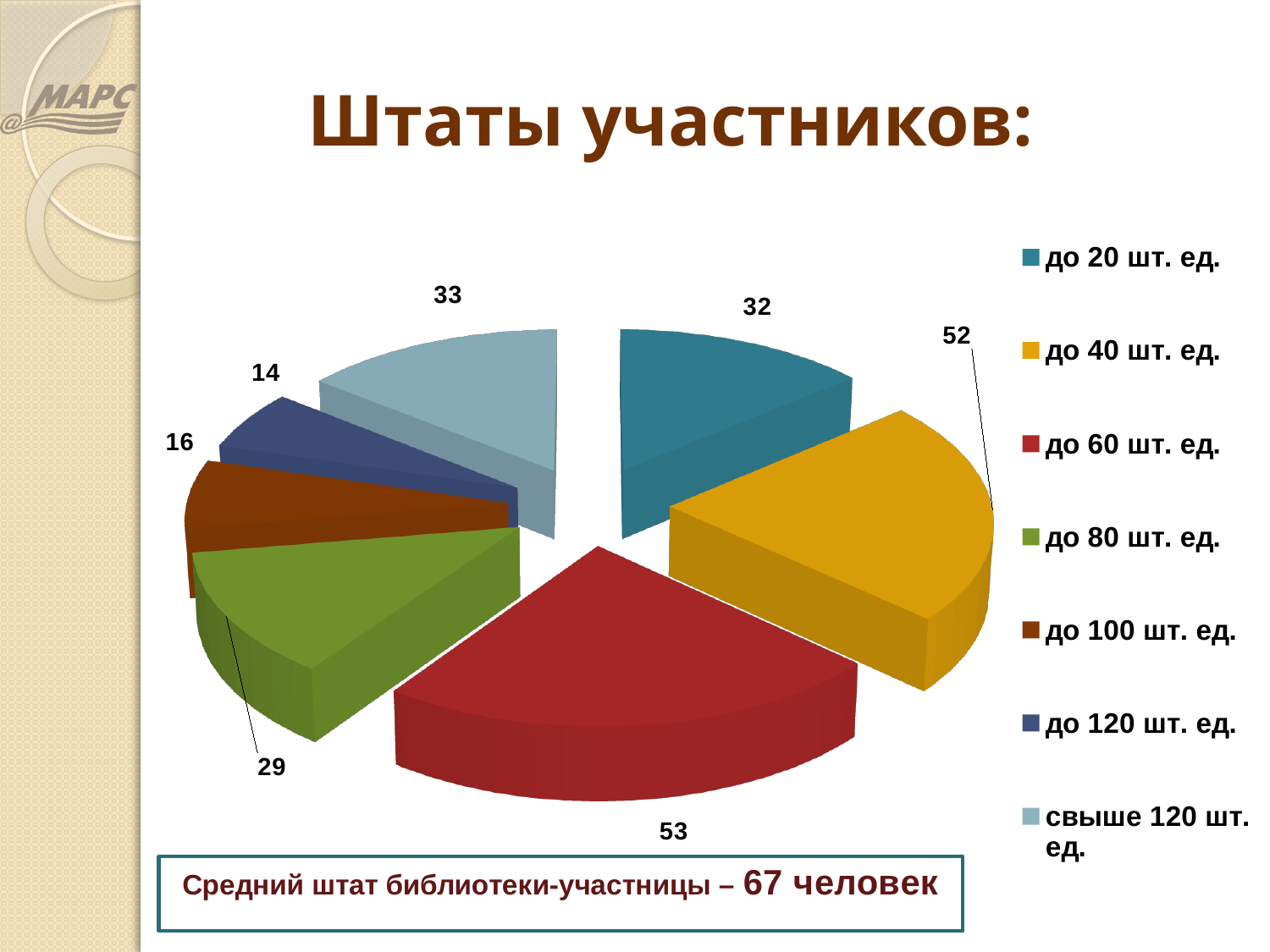
Which is larger, the value for "до 20 шт. ед." or the value for "свыше 120 шт. ед."? свыше 120 шт. ед. Which category has the smallest value? до 120 шт. ед. How many categories does the pie chart have? 7 What is the value for the category "до 60 шт. ед."? 53 What is the value for the category "до 40 шт. ед."? 52 Which category has the largest value? до 60 шт. ед. What is the difference between the values for "до 80 шт. ед." and "до 100 шт. ед."? 13 What type of chart is shown on the slide? Pie chart What is the title of the slide containing the chart? Штаты участников: What is the value for the category "свыше 120 шт. ед."? 33 What is the total of all the slice values in the pie chart? 229 What is the value for the category "до 20 шт. ед."? 32